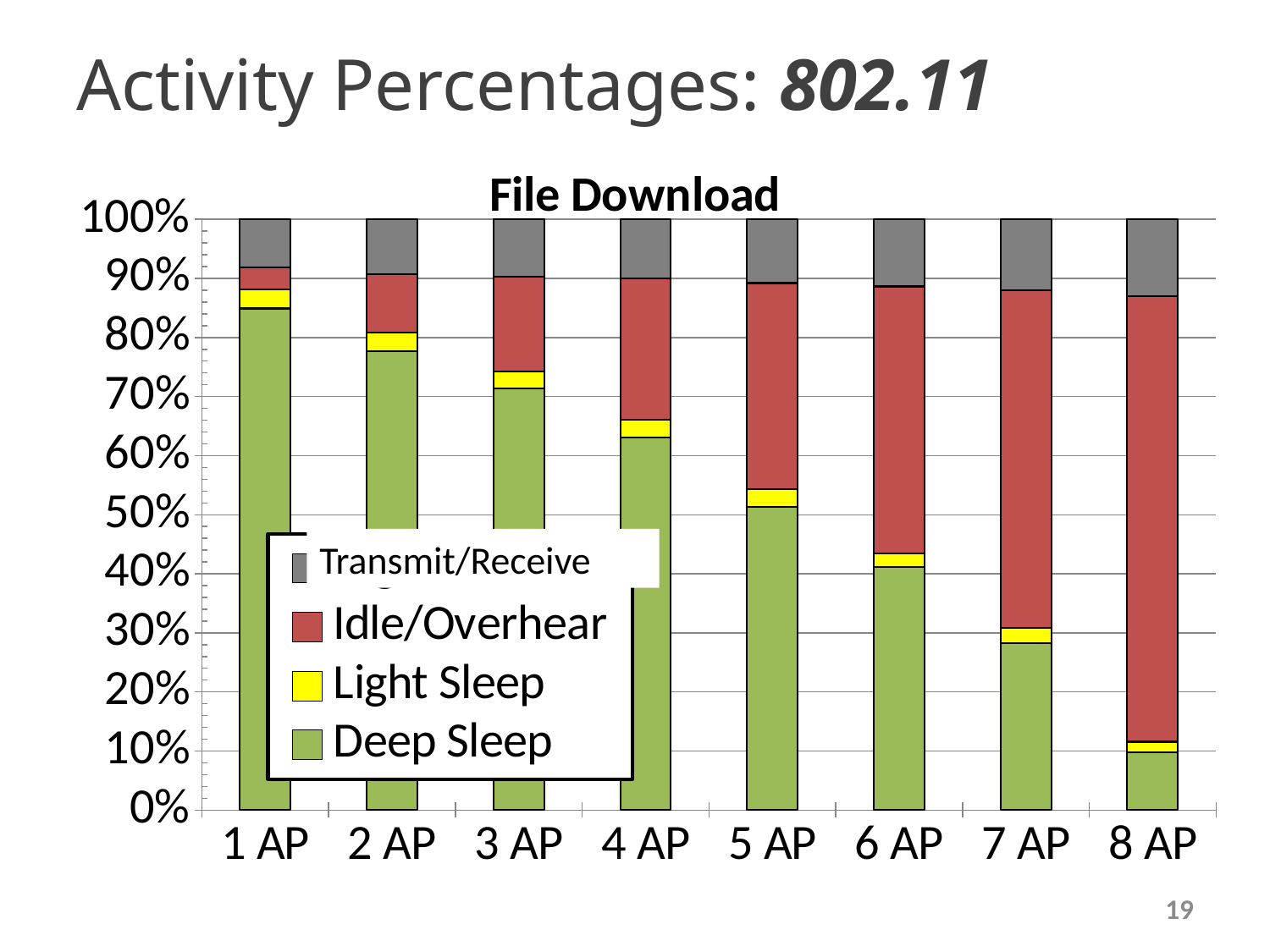
Is the Deep Sleep share for 4 AP greater or less than 60%? greater What kind of chart is shown on the slide? Stacked bar chart Which category has the largest Deep Sleep share? 1 AP Does the Deep Sleep share rise or fall as the number of APs increases from 1 AP to 8 AP? Fall Which category has the smallest Deep Sleep share? 8 AP Which has the larger Deep Sleep share, 3 AP or 6 AP? 3 AP How many categories are shown on the x axis? 8 Is the Deep Sleep share for 7 AP greater or less than 30%? less Which series is shown in green in the legend? Deep Sleep How many series does the legend list? 4 What is the title of the chart? File Download Which category has the largest Idle/Overhear share? 8 AP